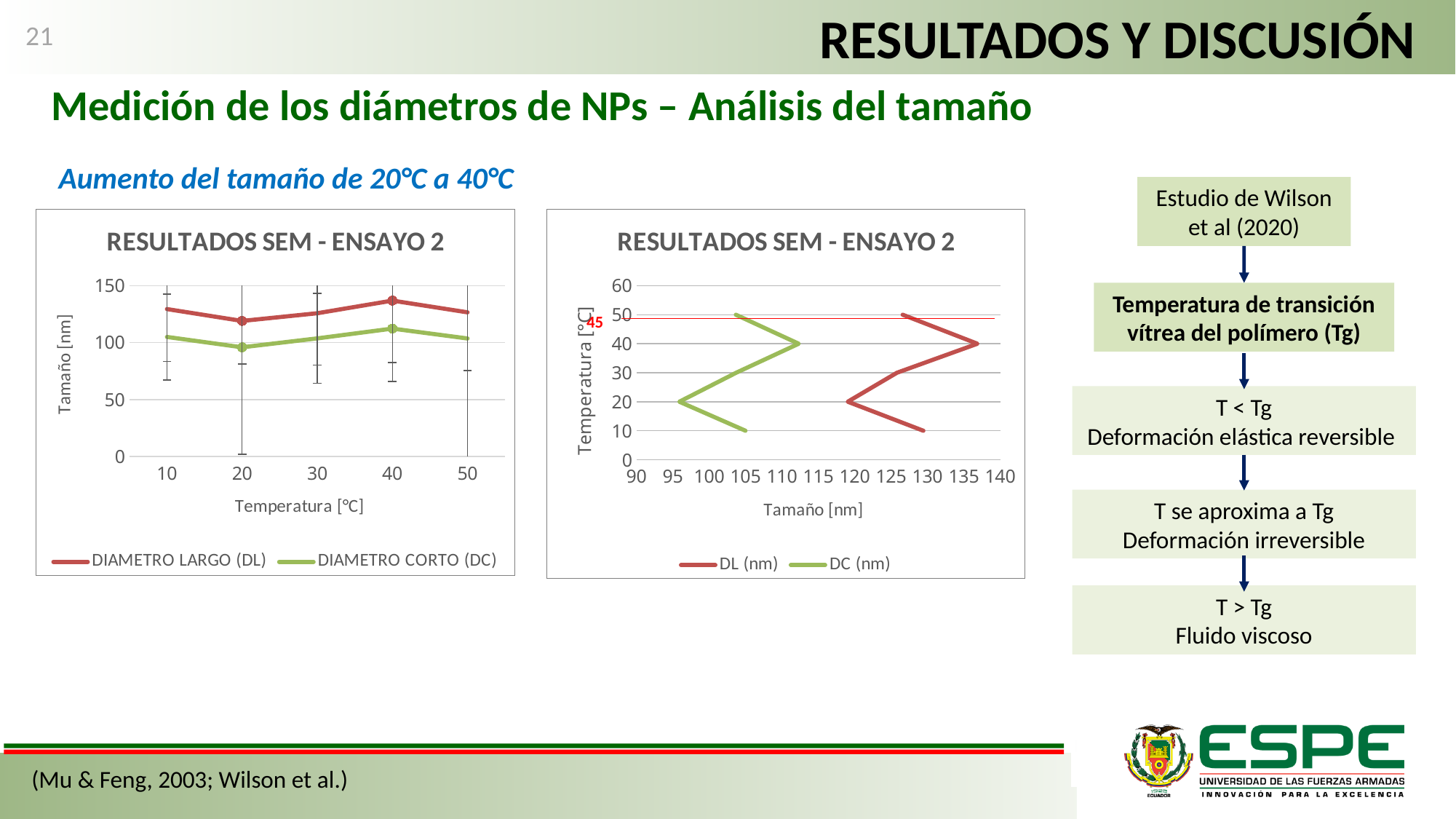
In the right chart, at which temperature is DC (nm) highest? 40 In the left chart, at which temperature is DIAMETRO LARGO (DL) highest? 40 What is the x-axis label of the right chart? Tamaño [nm] In the left chart, at which temperature is DIAMETRO CORTO (DC) lowest? 20 How many temperature points are plotted for each series in the left chart? 5 In the left chart, is the value of DIAMETRO LARGO (DL) at 40 °C greater or less than 100? greater In the left chart, which series is larger at 30 °C, DIAMETRO LARGO (DL) or DIAMETRO CORTO (DC)? DIAMETRO LARGO (DL) In the right chart, is the DL (nm) value at temperature 40 greater or less than 130? greater In the right chart, is the DC (nm) value at temperature 20 greater or less than 100? less What kind of chart is the left chart titled RESULTADOS SEM - ENSAYO 2? line chart How many series does the legend of the left chart list? 2